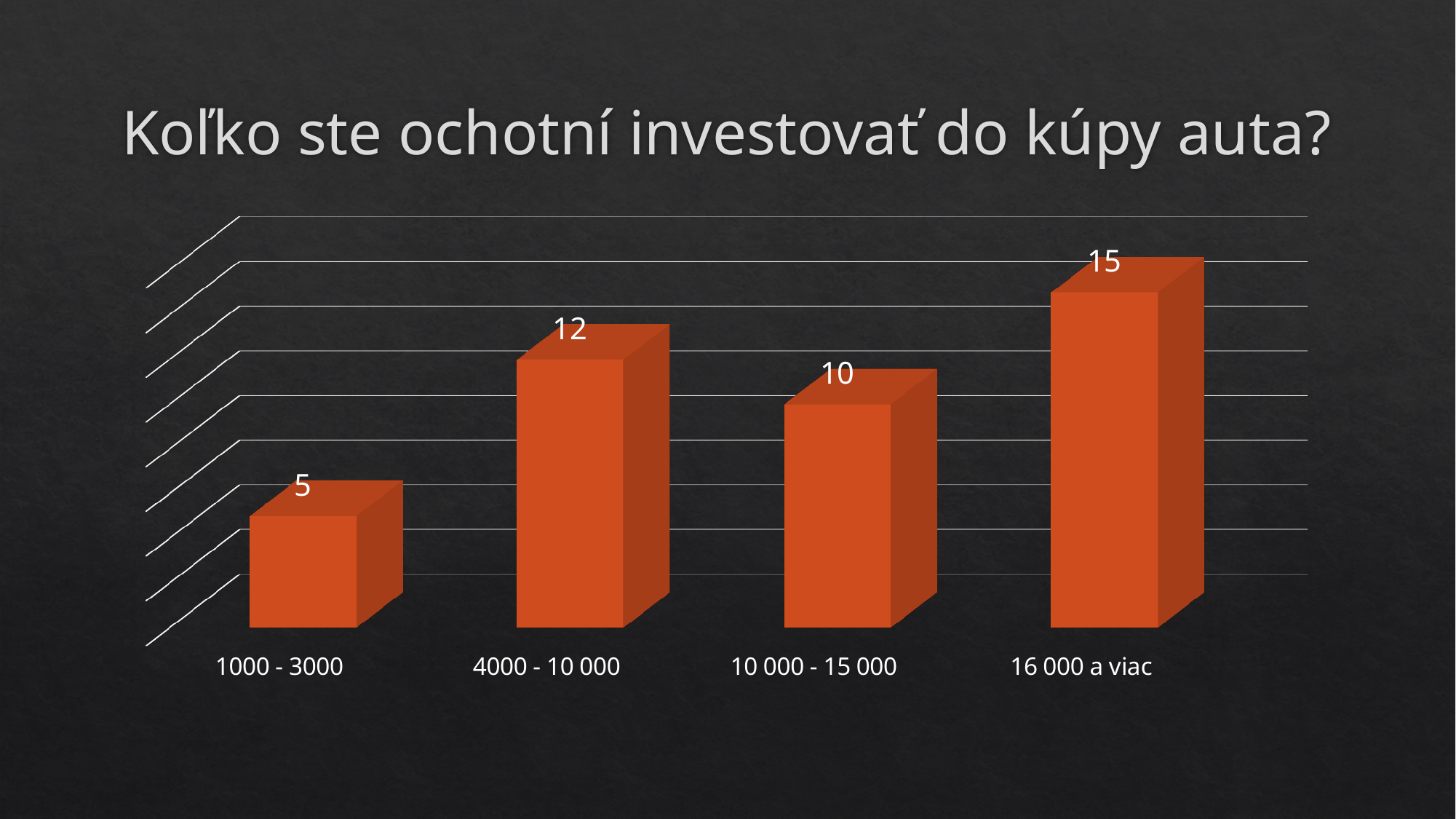
What is the value for the "1000 - 3000" category? 5 What is the difference between the values for "16 000 a viac" and "1000 - 3000"? 10 What kind of chart is shown on the slide? Bar chart How many categories are shown on the chart? 4 What is the title of the slide? Koľko ste ochotní investovať do kúpy auta? What is the value for the "10 000 - 15 000" category? 10 What is the value for the "16 000 a viac" category? 15 What is the difference between the values for "4000 - 10 000" and "10 000 - 15 000"? 2 Which category has the highest value? 16 000 a viac What is the value for the "4000 - 10 000" category? 12 Which is larger, the value for "4000 - 10 000" or the value for "10 000 - 15 000"? 4000 - 10 000 Which category has the lowest value? 1000 - 3000